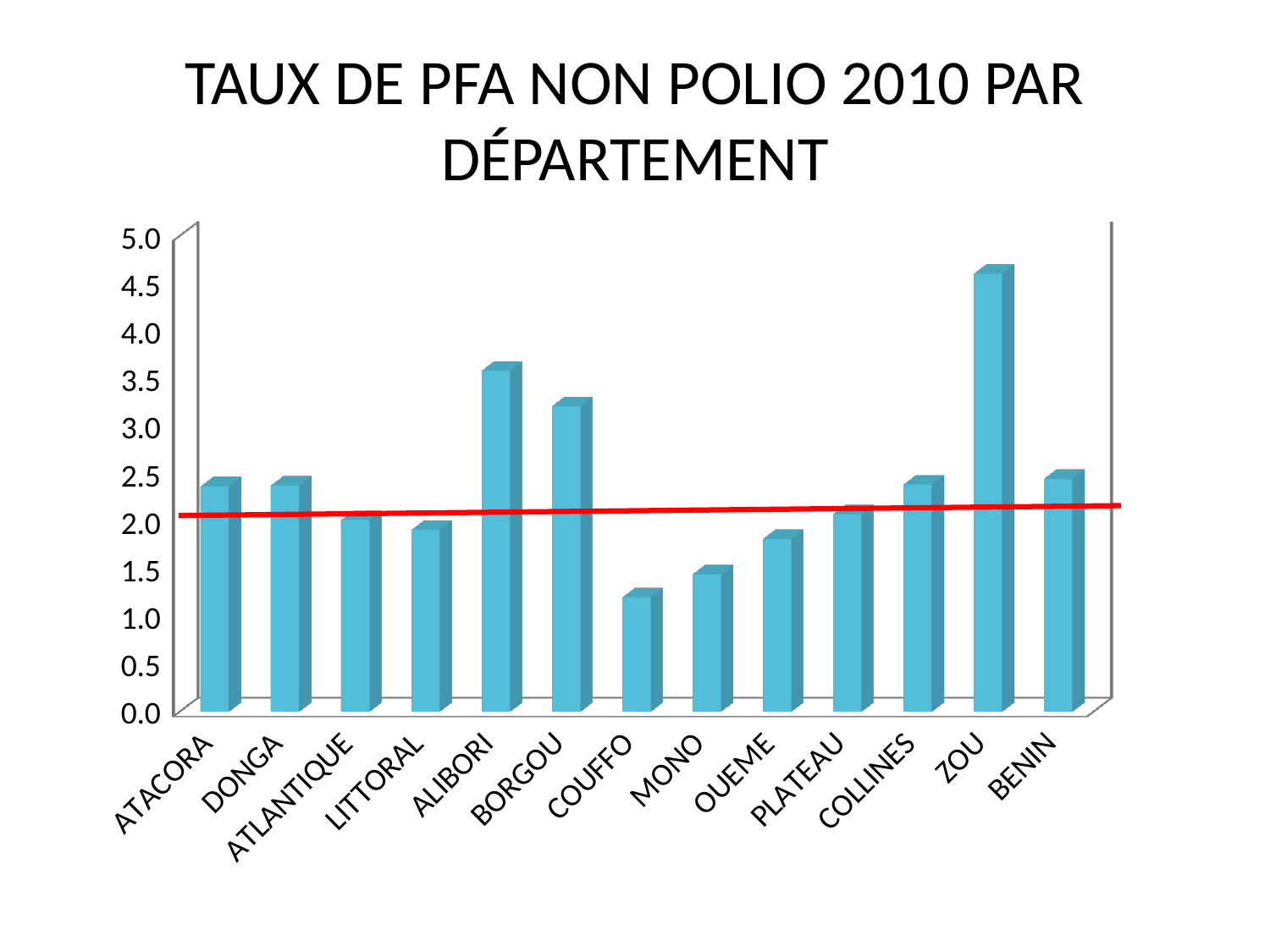
Which is larger, the value for ZOU or the value for BENIN? ZOU Which département has the highest bar? ZOU Is the value for ALIBORI greater or less than 3.0? greater What kind of chart is shown on the slide? bar chart How many départements (categories) are shown on the x axis? 13 Is the value for OUEME greater or less than 2.0? less What is the title of the chart? TAUX DE PFA NON POLIO 2010 PAR DÉPARTEMENT Is the value for ZOU greater or less than 4.0? greater Which is larger, the value for ALIBORI or the value for BORGOU? ALIBORI What colour is the horizontal reference line drawn across the chart? red Which département has the lowest bar? COUFFO